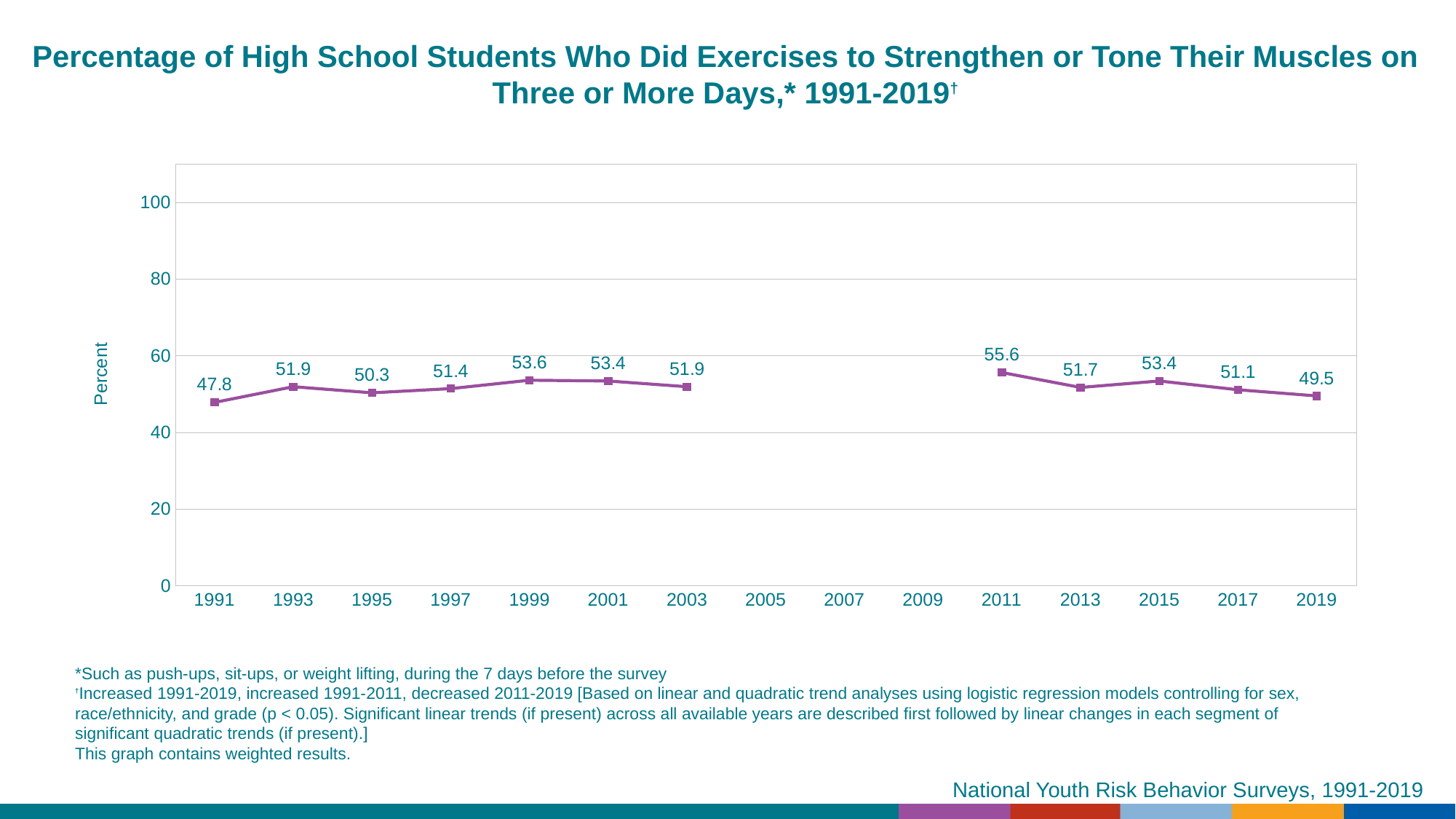
What is the difference between the values for 2011 and 2019? 6.1 What is the difference between the values for 1991 and 1993? 4.1 How many data points are plotted on the chart? 12 What is the value for 1991? 47.8 Which year has the highest value? 2011 What is the value for 2011? 55.6 Which is larger, the value for 1999 or the value for 2013? 1999 What is the value for 1999? 53.6 Which year has the lowest value? 1991 What kind of chart is shown? Line chart What is the label of the y axis? Percent What is the value for 2019? 49.5